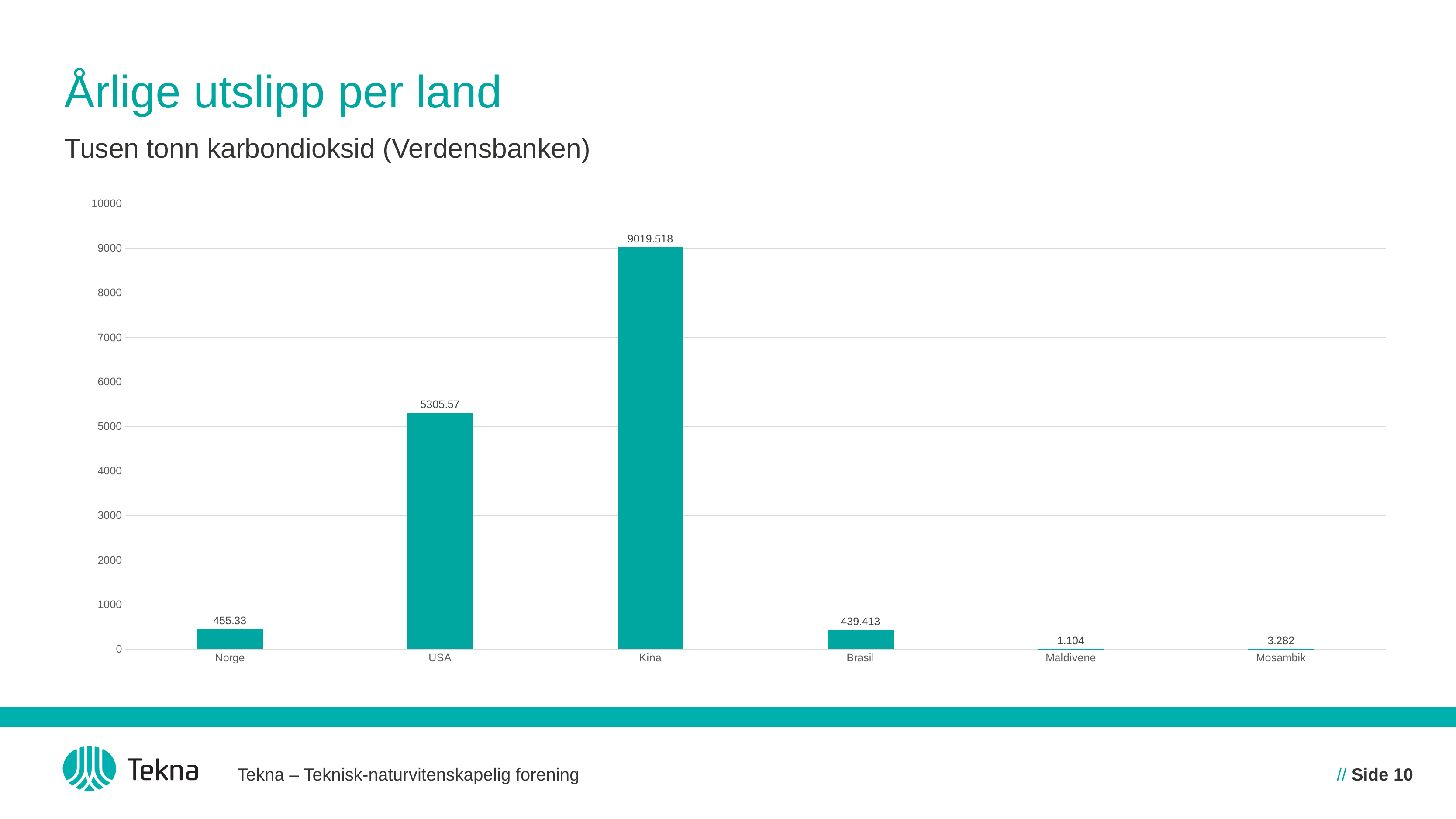
What is the value for Norge? 455.33 Which country has the lowest value? Maldivene What is the title of the slide? Årlige utslipp per land What is the value for Kina? 9019.518 What is the value for Maldivene? 1.104 What type of chart is shown on the slide? bar chart What is the difference between the values for Kina and USA? 3713.948 What is the value for USA? 5305.57 What is the difference between the values for Mosambik and Maldivene? 2.178 How many countries are shown in the chart? 6 Which has the larger value, Norge or Brasil? Norge Which country has the highest value? Kina